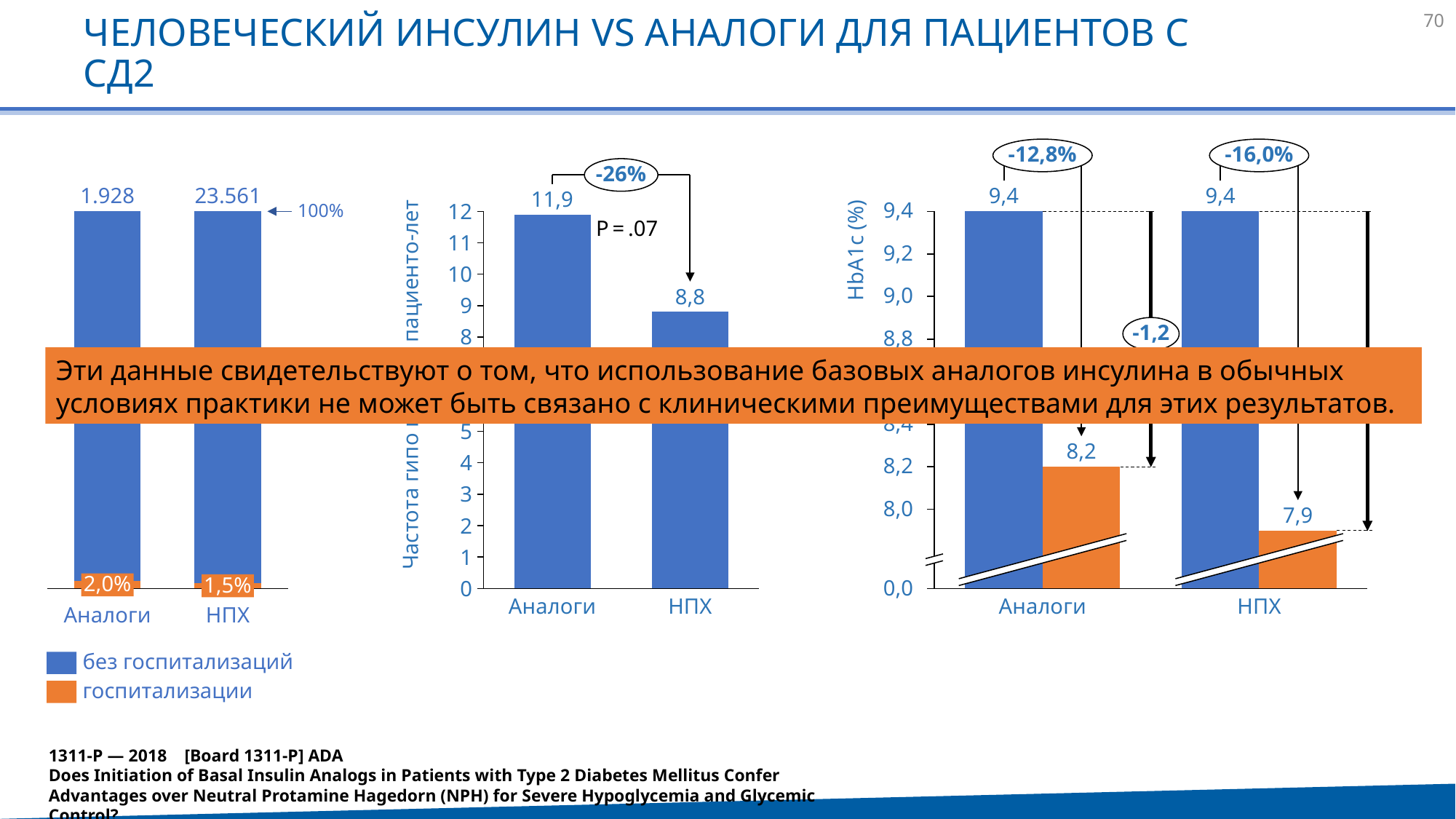
In the left chart, what percentage is shown for госпитализации for Аналоги? 2,0% In the right chart (HbA1c), what is the orange bar value for НПХ? 7,9 How many entries does the legend on the left list? 2 In the middle chart, what is the value for Аналоги? 11,9 In the middle chart, which category has the higher value, Аналоги or НПХ? Аналоги In the middle chart, what percentage change is shown between Аналоги and НПХ? -26% In the right chart (HbA1c), what percentage change is shown for НПХ? -16,0% In the right chart (HbA1c), what is the blue bar value for НПХ? 9,4 In the middle chart, what is the value for НПХ? 8,8 In the middle chart, what is the difference between the values for Аналоги and НПХ? 3,1 In the left chart, what number is printed above the НПХ bar? 23.561 In the right chart (HbA1c), what is the orange bar value for Аналоги? 8,2